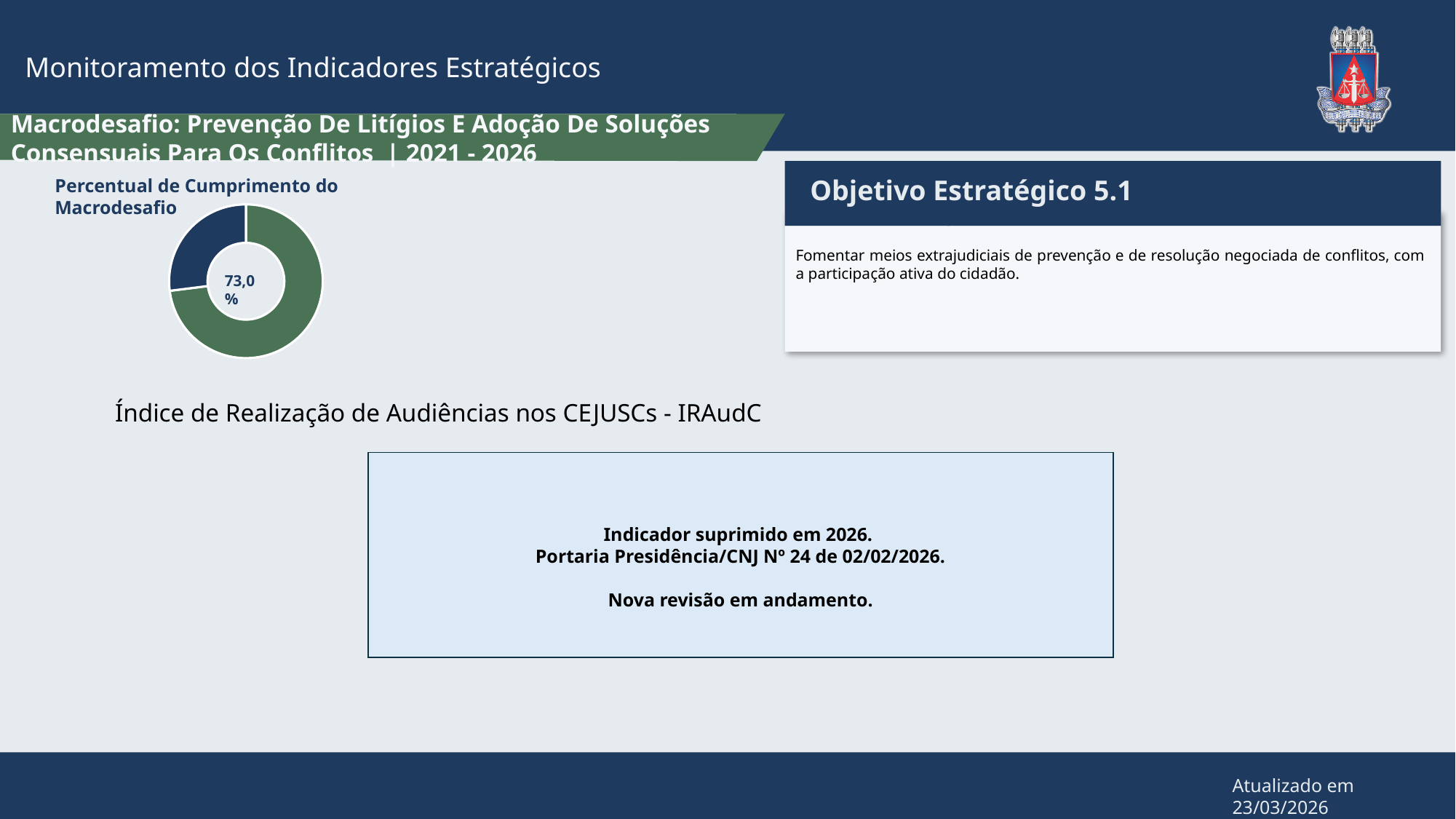
What is the title of the donut chart on the slide? Percentual de Cumprimento do Macrodesafio How many slices does the "Percentual de Cumprimento do Macrodesafio" donut chart have? 2 What kind of chart is shown under the title "Percentual de Cumprimento do Macrodesafio"? donut (pie) chart Which colour slice takes up the largest share of the "Percentual de Cumprimento do Macrodesafio" donut chart? green What two colours are used for the slices of the "Percentual de Cumprimento do Macrodesafio" chart? green and dark blue What value is printed in the centre of the "Percentual de Cumprimento do Macrodesafio" chart? 73,0 % Which colour slice is the smallest in the "Percentual de Cumprimento do Macrodesafio" donut chart? dark blue In the "Percentual de Cumprimento do Macrodesafio" chart, which slice is larger, the green one or the dark blue one? the green one